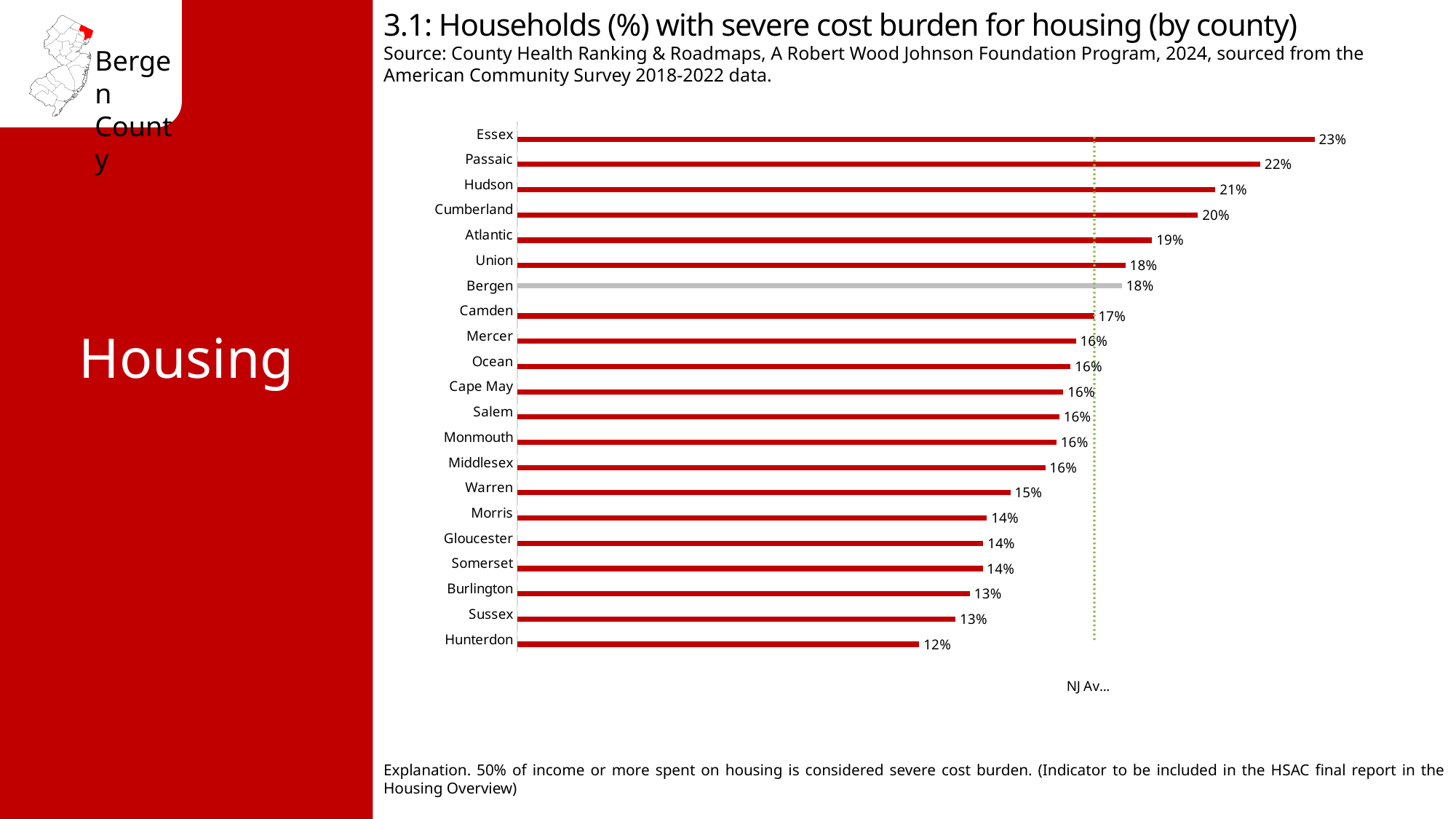
What is the value for Hunterdon? 12% Which is larger, the value for Hudson or the value for Atlantic? Hudson What is the value for Bergen? 18% What kind of chart is this? Bar chart Which county has the lowest percentage of households with severe cost burden? Hunterdon What is the value for Essex? 23% How many counties are shown in the chart? 21 What is the value for Cumberland? 20% Which county's bar is shown in grey instead of red? Bergen Which county has the highest percentage of households with severe cost burden? Essex What is the difference between the values for Essex and Hunterdon? 11% What is the difference between the values for Passaic and Bergen? 4%